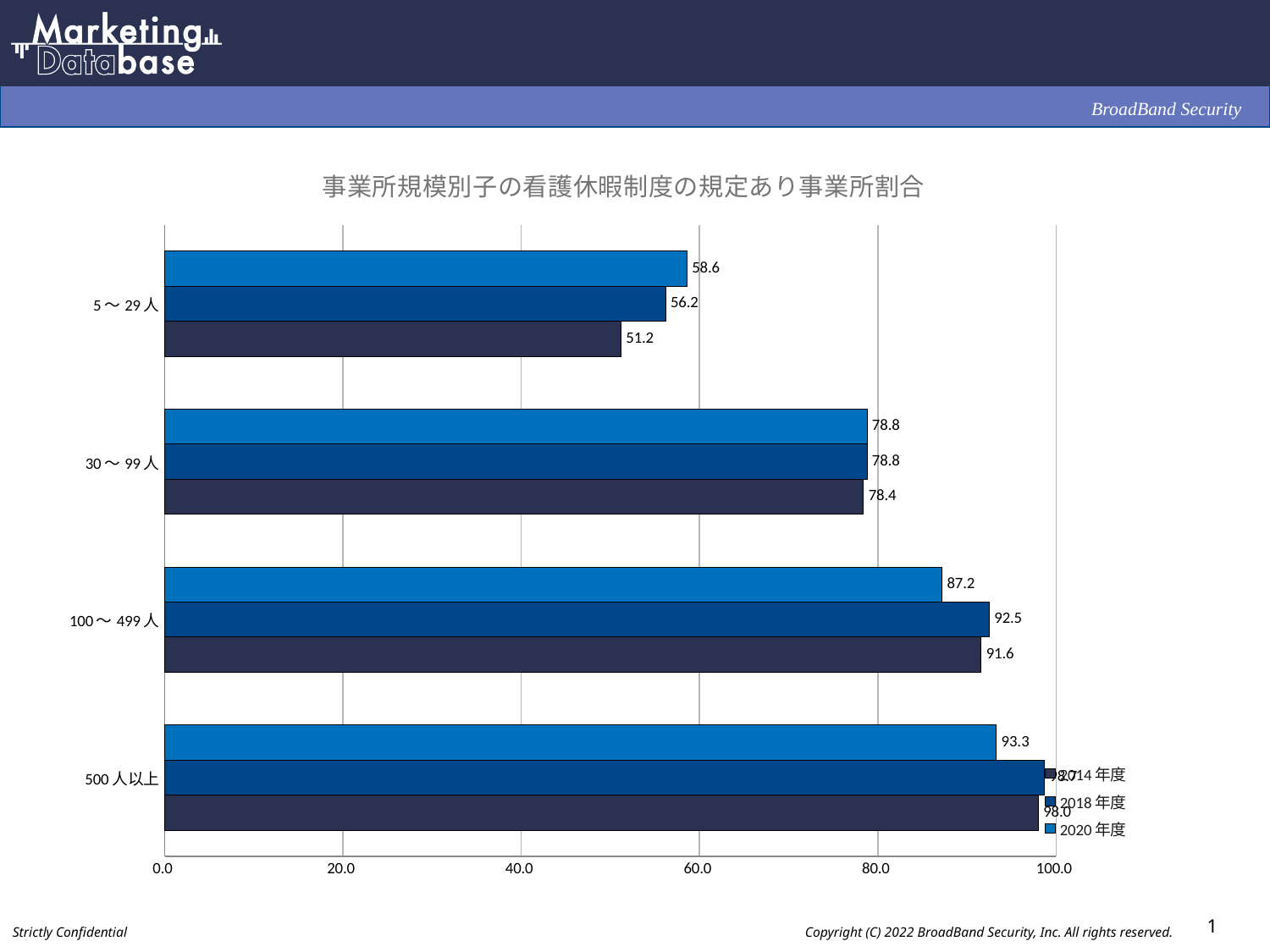
How many series does the legend list? 3 What is the 2020年度 value for 5～29人? 58.6 What is the difference between the 2020年度 and 2014年度 values for 5～29人? 7.4 How many establishment-size categories are shown on the y axis? 4 What is the 2014年度 value for 30～99人? 78.4 Is the 2014年度 value for 100～499人 greater or less than 80.0? greater What is the 2014年度 value for 5～29人? 51.2 What is the 2018年度 value for 100～499人? 92.5 What type of chart is shown on the slide? bar chart Which category has the lowest 2020年度 value? 5～29人 Which is larger for 100～499人, the 2018年度 value or the 2020年度 value? 2018年度 What is the 2020年度 value for 500人以上? 93.3